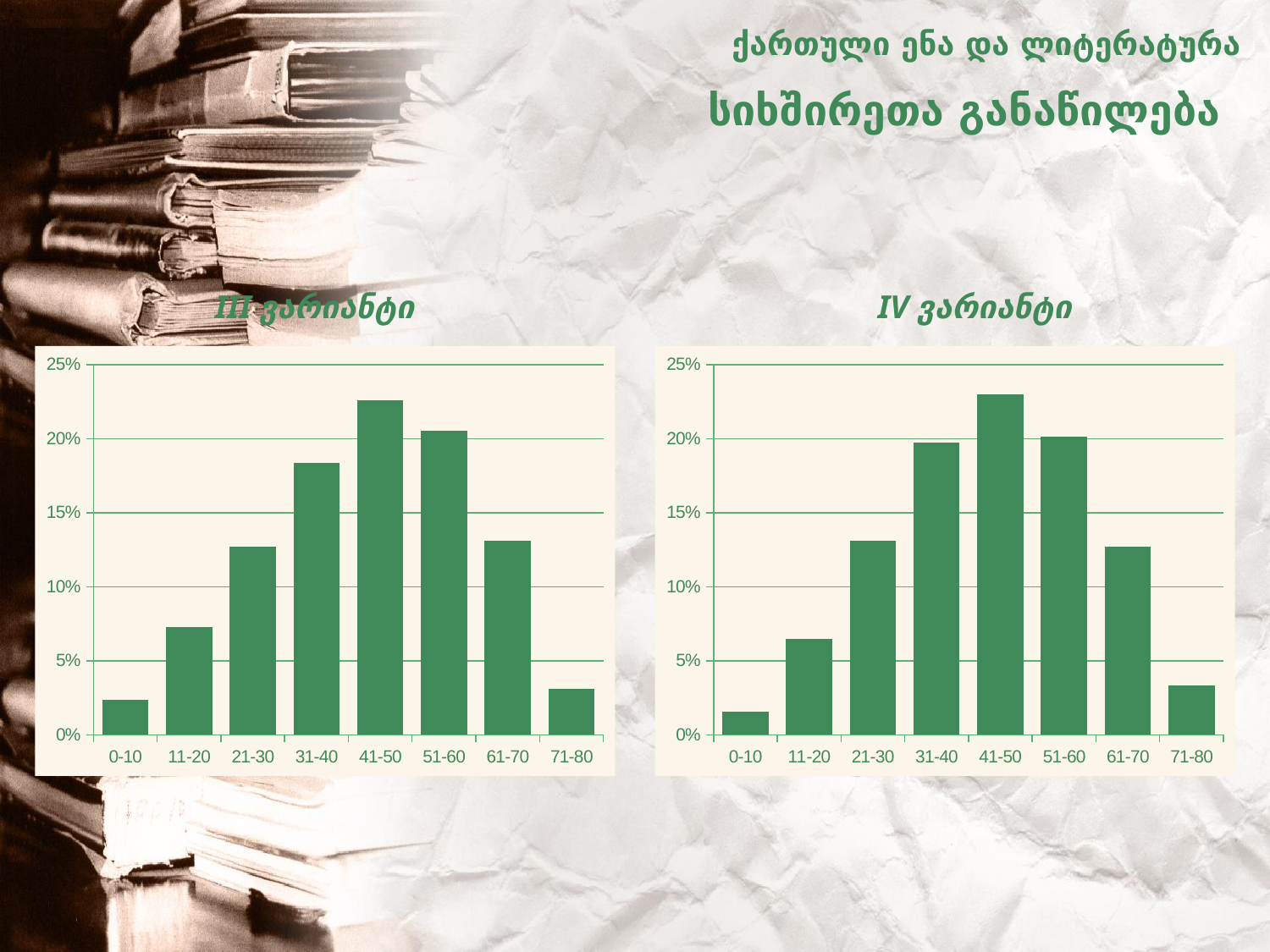
In the left chart (III ვარიანტი), which category has the highest value? 41-50 In the right chart (IV ვარიანტი), is the value for 31-40 greater or less than 15%? greater What is the title of the chart on the right side of the slide? IV ვარიანტი In the left chart (III ვარიანტი), which is larger, the value for 31-40 or the value for 61-70? 31-40 What kind of chart is the right chart (IV ვარიანტი)? bar chart In the right chart (IV ვარიანტი), which category has the highest value? 41-50 In the right chart (IV ვარიანტი), which category has the lowest value? 0-10 In the left chart (III ვარიანტი), which category has the lowest value? 0-10 In the right chart (IV ვარიანტი), is the value for 11-20 greater or less than 10%? less In the left chart (III ვარიანტი), is the value for 41-50 greater or less than 20%? greater In the right chart (IV ვარიანტი), do the values rise or fall from 0-10 to 41-50? rise How many categories are shown on the x axis of the left chart (III ვარიანტი)? 8